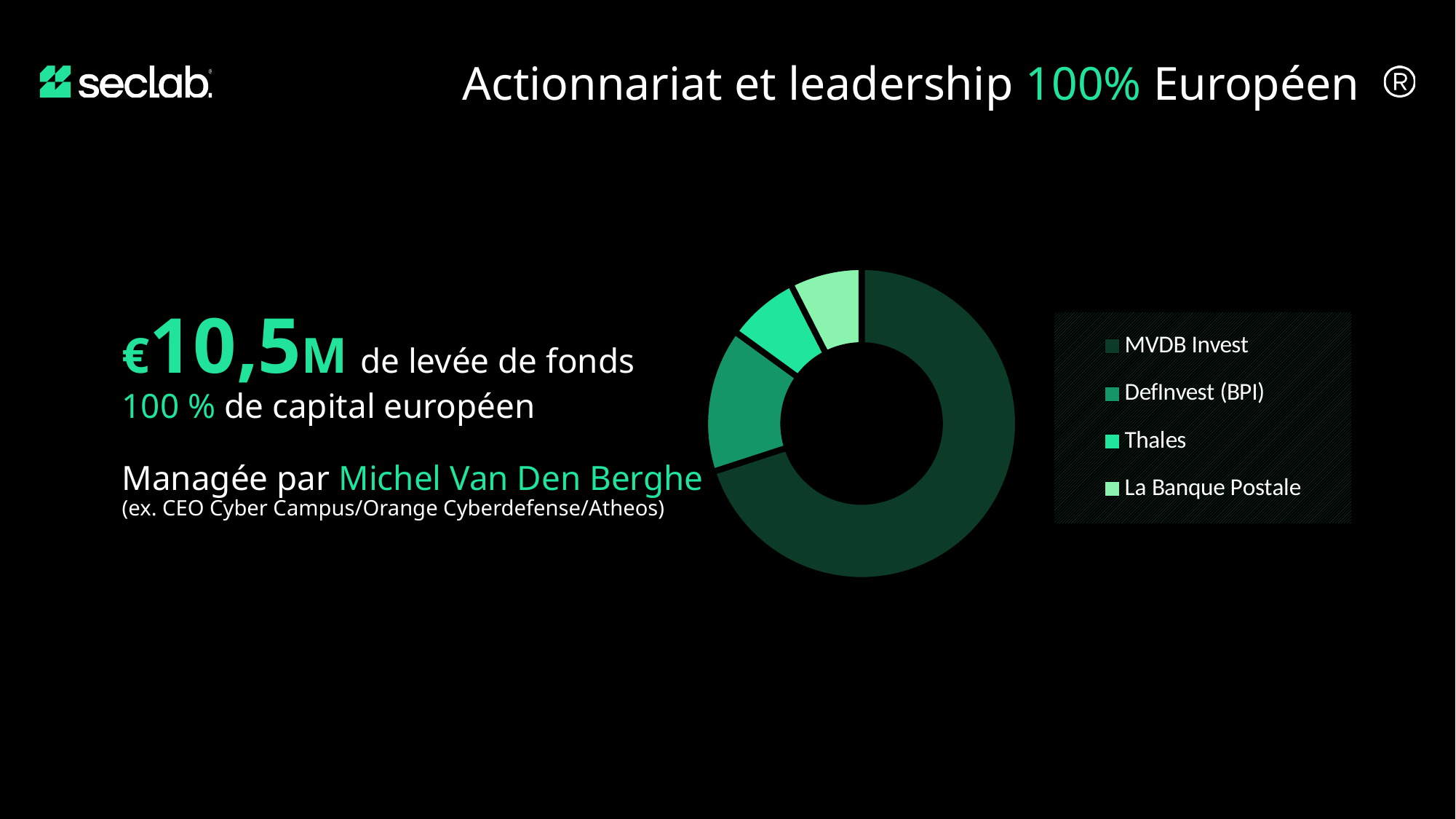
Which shareholder is listed first in the pie chart's legend? MVDB Invest Which slice is larger in the pie chart, MVDB Invest or La Banque Postale? MVDB Invest How many shareholder categories does the pie chart show? 4 Which slice is larger in the pie chart, DefInvest (BPI) or Thales? DefInvest (BPI) What kind of chart is shown on the slide? Pie chart (donut) Which slice is larger in the pie chart, MVDB Invest or DefInvest (BPI)? MVDB Invest Which shareholder is listed last in the pie chart's legend? La Banque Postale Which shareholder has the largest slice of the pie chart? MVDB Invest